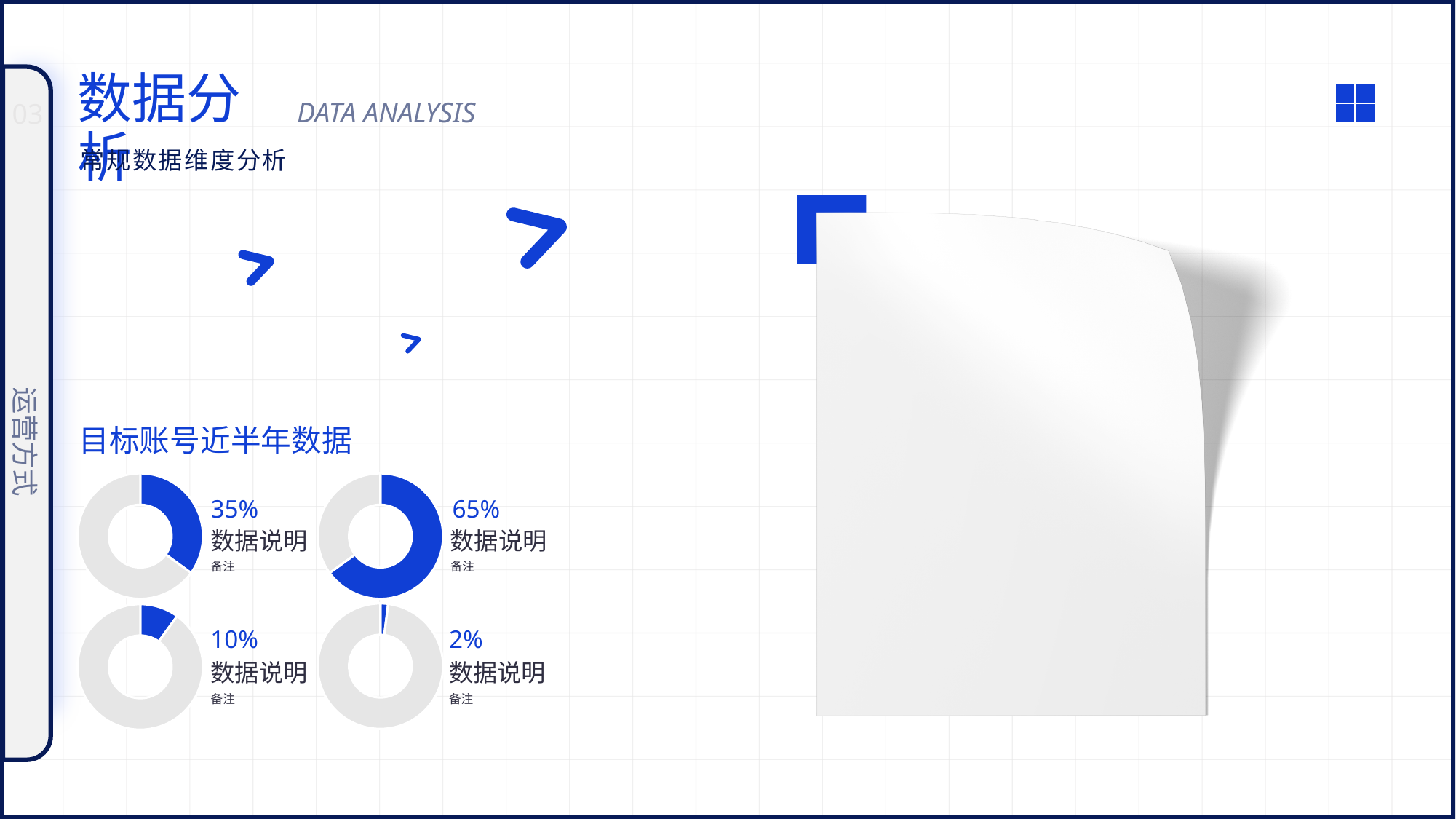
What is the difference between the percentages of the top-right and top-left donut charts? 30% Which of the four donut charts shows the lowest percentage? The bottom-right one (2%) What percentage is shown next to the top-right donut chart? 65% What percentage is shown next to the bottom-right donut chart? 2% What colour is used for the filled portion of each donut chart? Blue Which of the four donut charts shows the highest percentage? The top-right one (65%) What type of chart is used to display the percentages on the slide? Donut (pie) chart Which is larger, the percentage of the bottom-left donut chart or the bottom-right donut chart? The bottom-left (10%) What is the heading above the group of donut charts? 目标账号近半年数据 What percentage is shown next to the bottom-left donut chart? 10% What percentage is shown next to the top-left donut chart under "目标账号近半年数据"? 35% How many donut charts are shown on the slide? 4